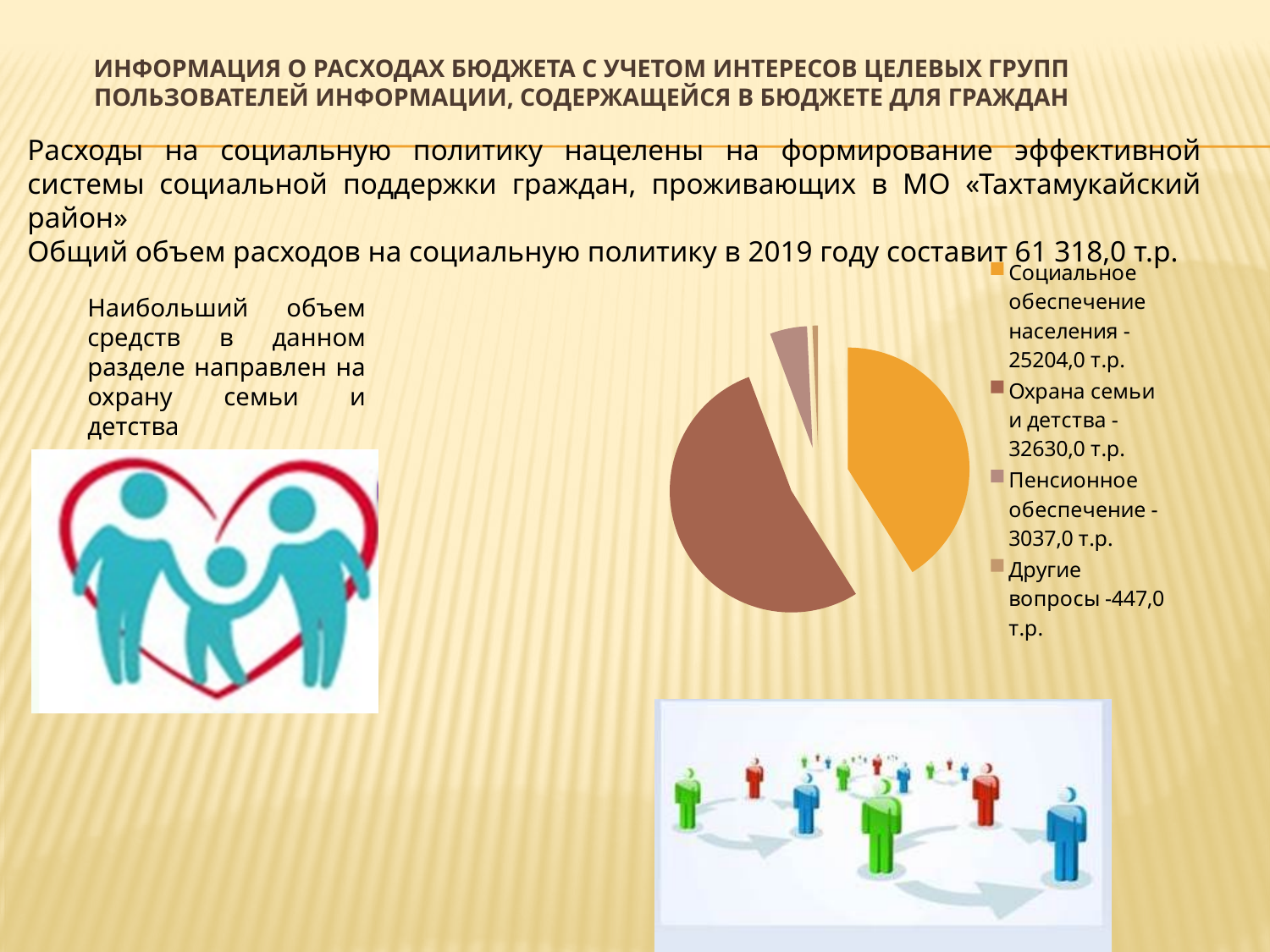
Which is larger: Пенсионное обеспечение or Другие вопросы? Пенсионное обеспечение What colour is the slice for Социальное обеспечение населения in the pie chart? Orange Which category has the smallest slice in the pie chart? Другие вопросы What is the value for Социальное обеспечение населения in the pie chart? 25204,0 т.р. How many categories does the pie chart's legend list? 4 What is the value for Охрана семьи и детства in the pie chart? 32630,0 т.р. What is the total of all four categories in the pie chart? 61318,0 т.р. What is the value for Другие вопросы in the pie chart? 447,0 т.р. Which category has the largest slice in the pie chart? Охрана семьи и детства What is the value for Пенсионное обеспечение in the pie chart? 3037,0 т.р. What is the difference between the values for Охрана семьи и детства and Социальное обеспечение населения? 7426,0 т.р. What kind of chart is shown on the slide? Pie chart